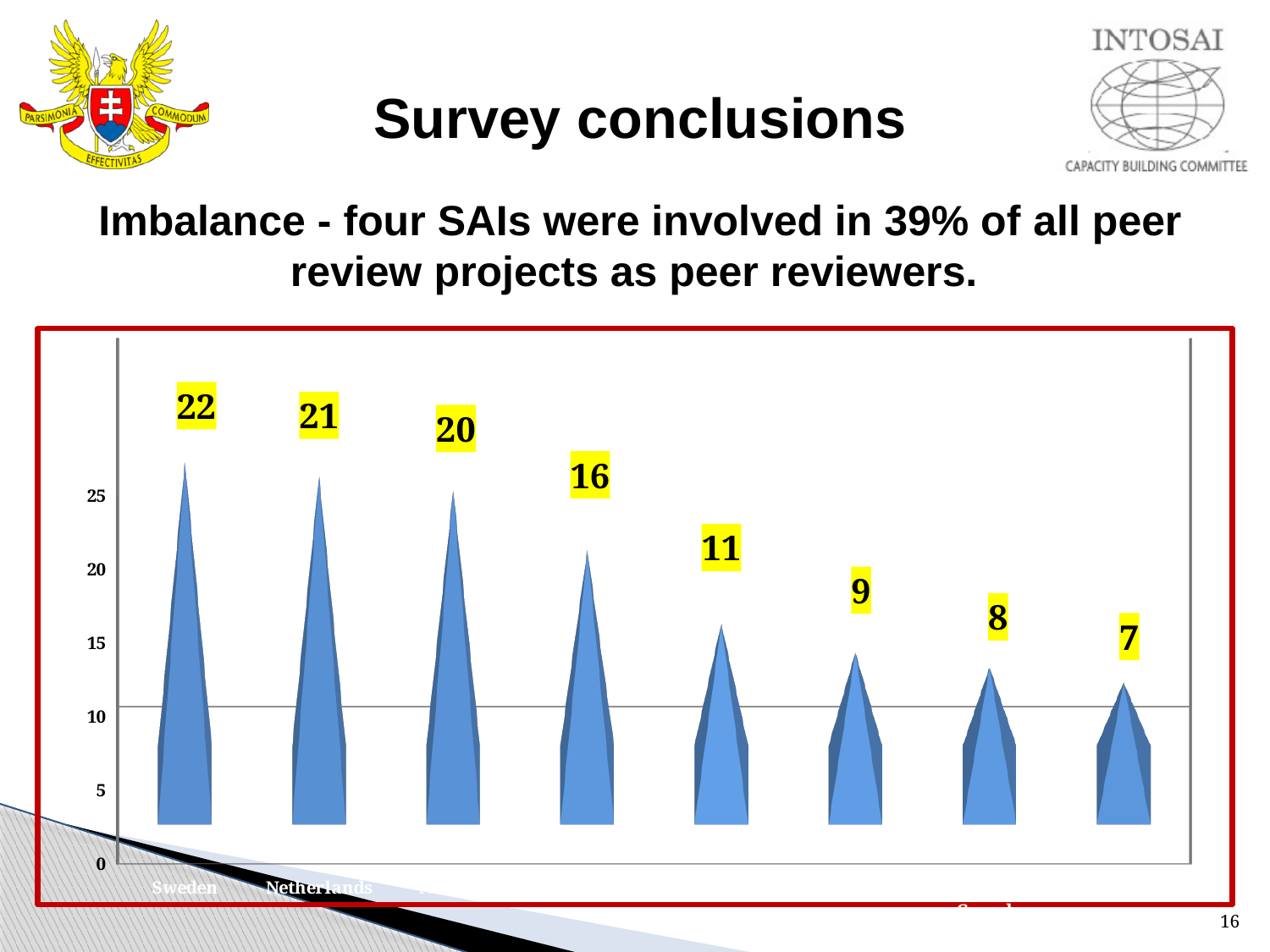
What colour are the bars in the chart? blue What is the difference between the values for Sweden and Netherlands? 1 How many categories are plotted in the chart? 8 What is the lowest value shown in the chart? 7 What is the value for Netherlands? 21 Which category has the highest value? Sweden What is the value for Sweden? 22 Which is larger, the value for Sweden or the value for Netherlands? Sweden What is the highest value shown in the chart? 22 Do the values rise or fall from left to right along the x axis? fall What is the value of the fourth category from the left? 16 What kind of chart is shown on the slide? bar chart